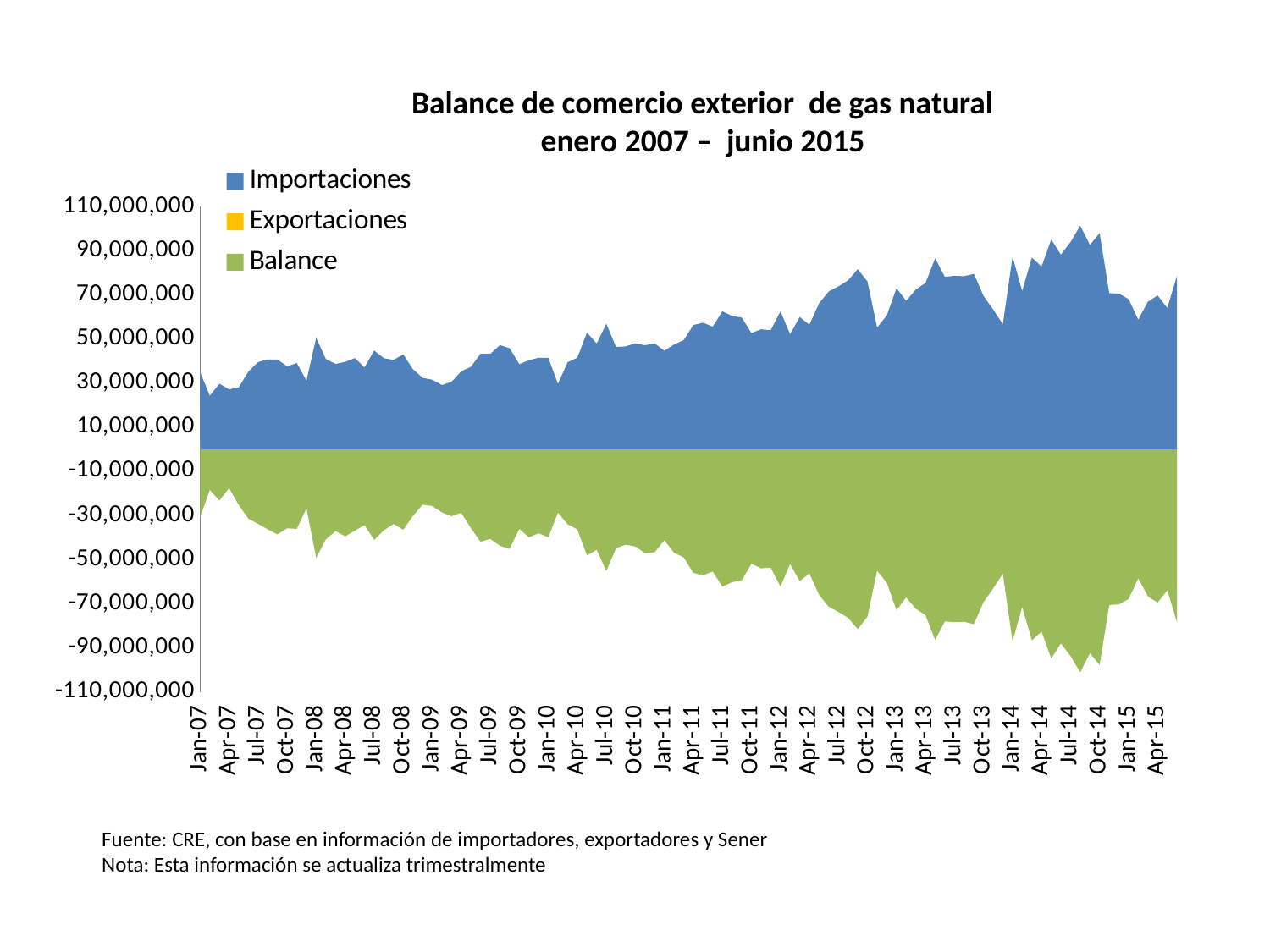
Is the Importaciones value around Jul-14 greater or less than 70,000,000? greater Do the Importaciones values generally rise or fall from Jan-07 to 2015? rise Which colour represents the Balance series? green Is the Importaciones value around Jan-09 greater or less than 50,000,000? less Which is larger, the Importaciones value around Jul-14 or the Importaciones value around Jan-09? Jul-14 What kind of chart is shown on the slide? area chart Do the Balance values generally rise or fall from Jan-07 to 2015? fall Is the Balance value around Jan-09 greater or less than -50,000,000? greater What is the title of the chart? Balance de comercio exterior de gas natural enero 2007 – junio 2015 How many series does the legend list? 3